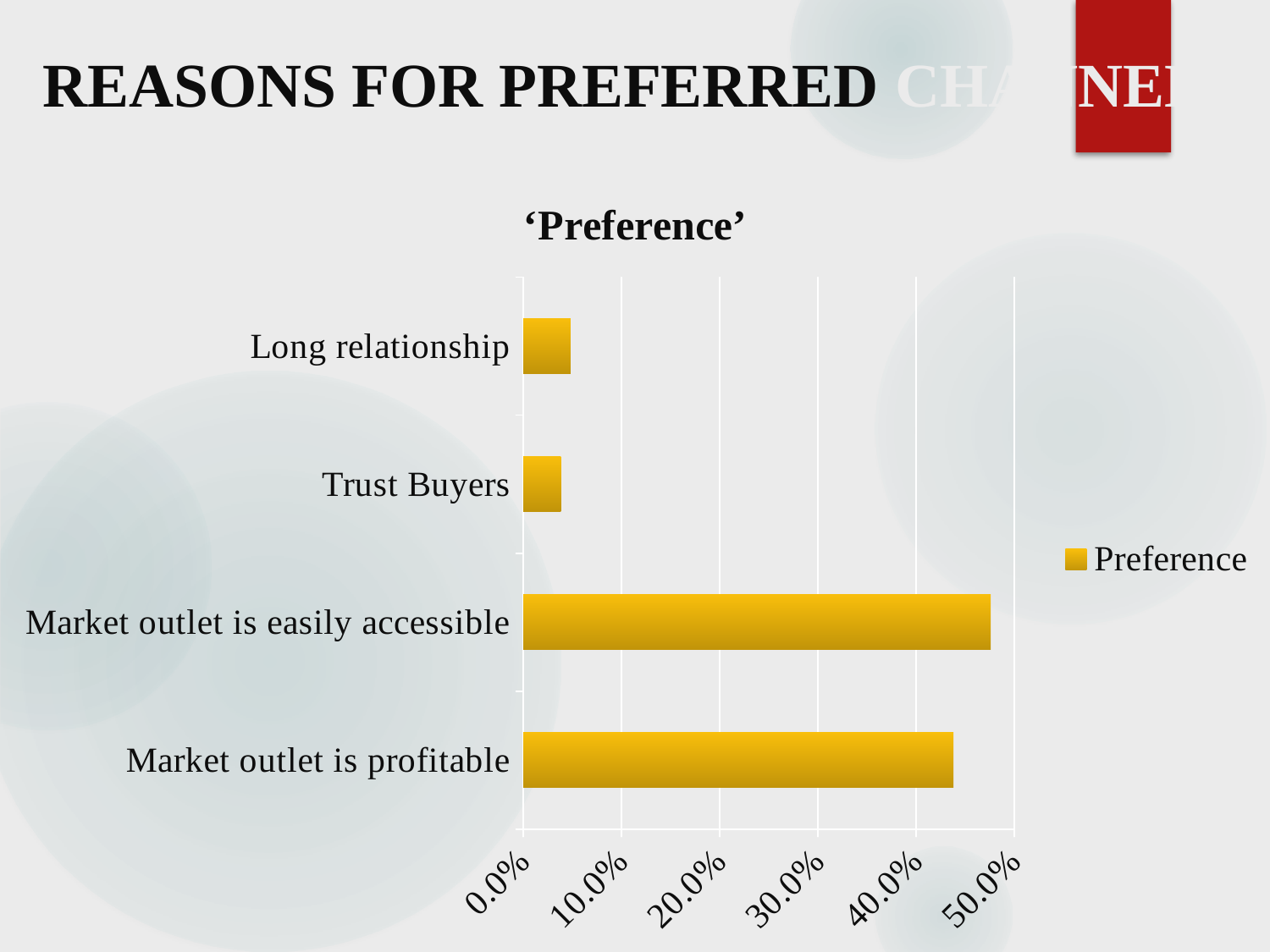
Is the value for Market outlet is profitable greater or less than 40.0%? greater How many categories are shown in the chart? 4 How many series does the legend list? 1 Is the value for Market outlet is easily accessible greater or less than 40.0%? greater Is the value for Long relationship greater or less than 10.0%? less What is the title of the chart? 'Preference' Which category has the highest value? Market outlet is easily accessible Which is larger, the value for Market outlet is profitable or the value for Long relationship? Market outlet is profitable What kind of chart is shown on the slide? bar chart Which is larger, the value for Market outlet is easily accessible or the value for Market outlet is profitable? Market outlet is easily accessible What is the name of the series shown in the legend? Preference